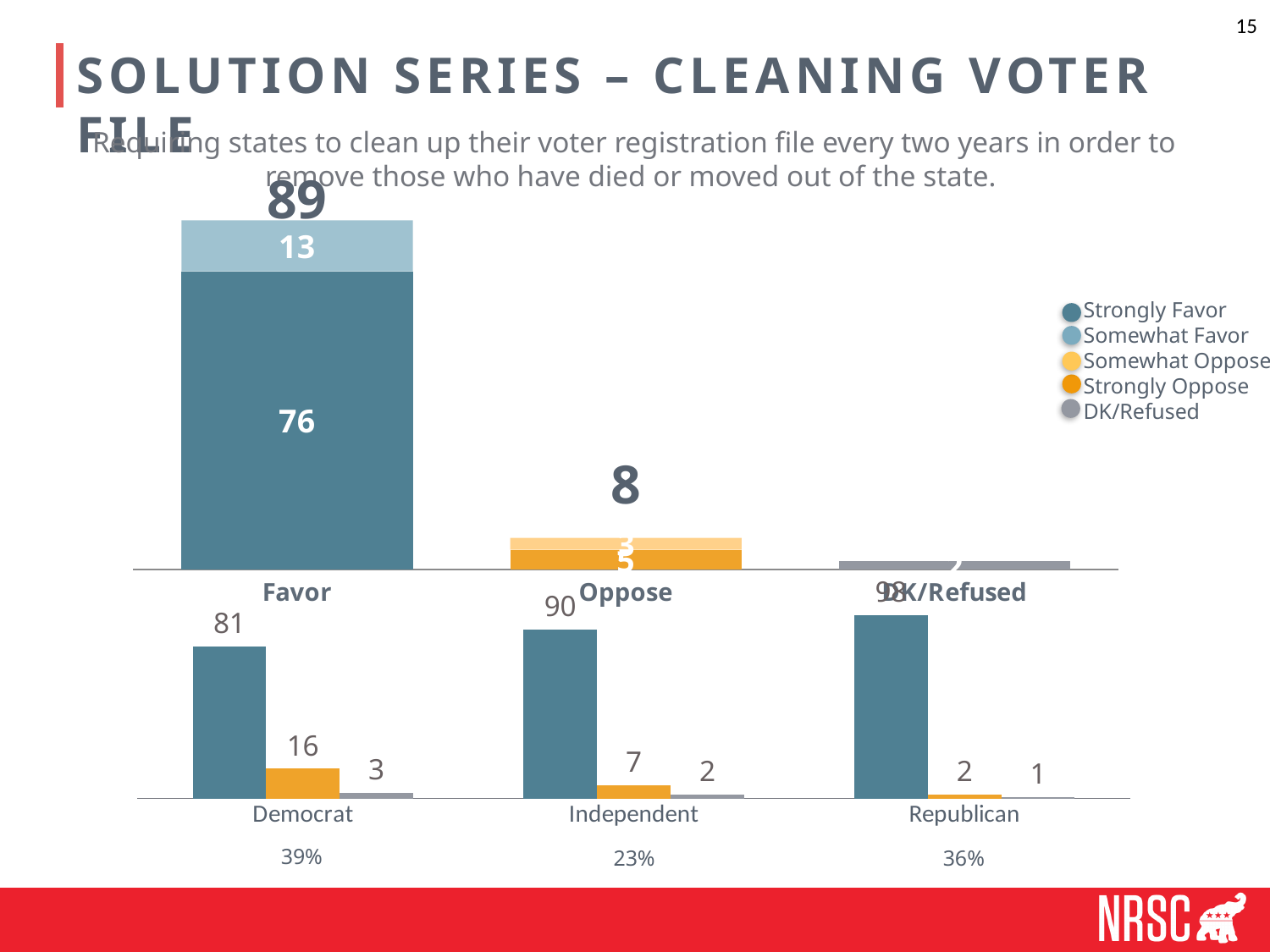
In the bottom chart, what is the Favor value for Independent? 90 In the top chart, what is the total for the Favor bar? 89 In the bottom chart, which party has the highest Oppose value? Democrat In the top chart, what is the Strongly Favor value in the Favor bar? 76 In the bottom chart, what is the Favor value for Democrat? 81 In the top chart, what is the difference between the Favor total and the Oppose total? 81 In the top chart, what is the Somewhat Favor value in the Favor bar? 13 How many series does the legend list? 5 In the bottom chart, what is the difference between the Oppose values for Democrat and Independent? 9 In the bottom chart, what is the Oppose value for Democrat? 16 In the top chart, which bar is the highest? Favor In the top chart, what is the total for the Oppose bar? 8